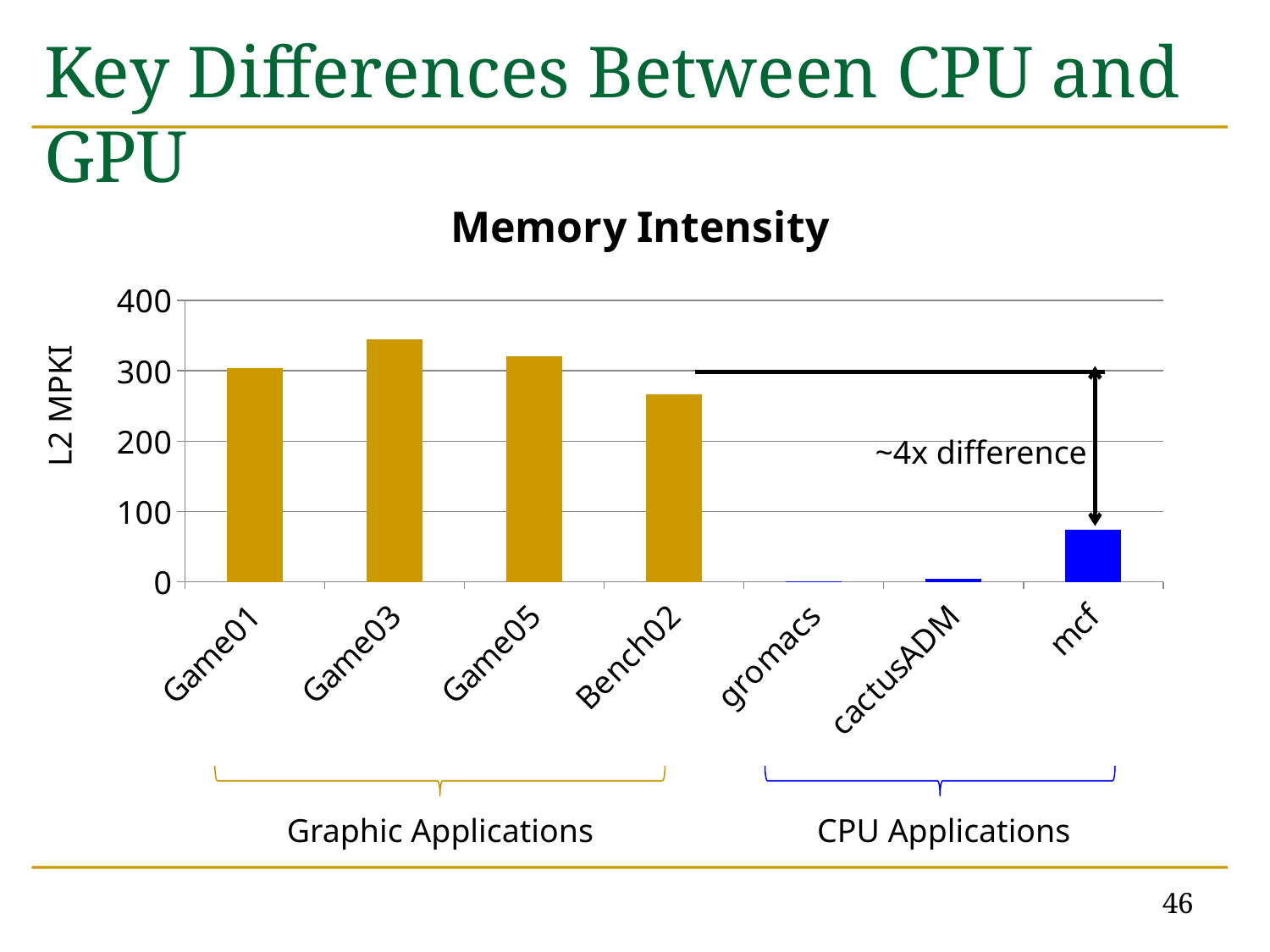
What is the title of the chart? Memory Intensity Which has a larger L2 MPKI value, Game03 or Bench02? Game03 How many categories are shown on the x axis of the chart? 7 Is the value for Game03 greater or less than 300? greater Which of the CPU Applications has the highest L2 MPKI value? mcf Which category has the highest L2 MPKI value? Game03 Which has a larger L2 MPKI value, mcf or Game01? Game01 Is the value for mcf greater or less than 100? less What is the label on the y axis of the chart? L2 MPKI Is the value for Bench02 greater or less than 300? less What kind of chart is shown on the slide? bar chart Which of the Graphic Applications has the lowest L2 MPKI value? Bench02